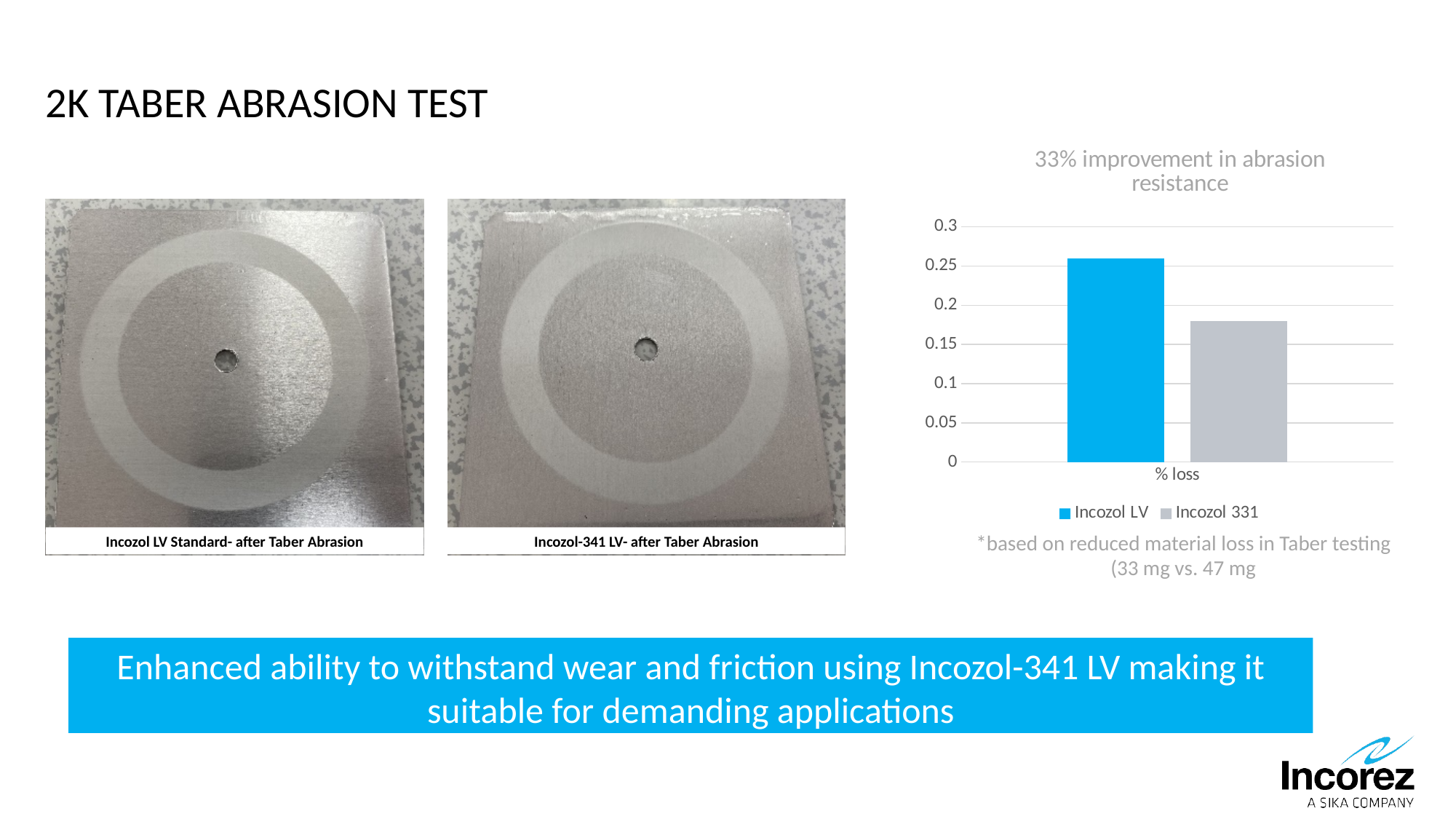
Is the % loss value for Incozol 331 greater or less than 0.2? less How many categories are shown on the x axis of the chart? 1 What is the category label shown on the x axis of the chart? % loss What kind of chart is shown on the slide? bar chart How many series does the chart legend list? 2 Which series shows the lowest % loss in the chart? Incozol 331 What is the title of the chart? 33% improvement in abrasion resistance Which series has the higher % loss, Incozol LV or Incozol 331? Incozol LV Is the % loss value for Incozol LV greater or less than 0.3? less Is the % loss value for Incozol 331 greater or less than 0.15? greater